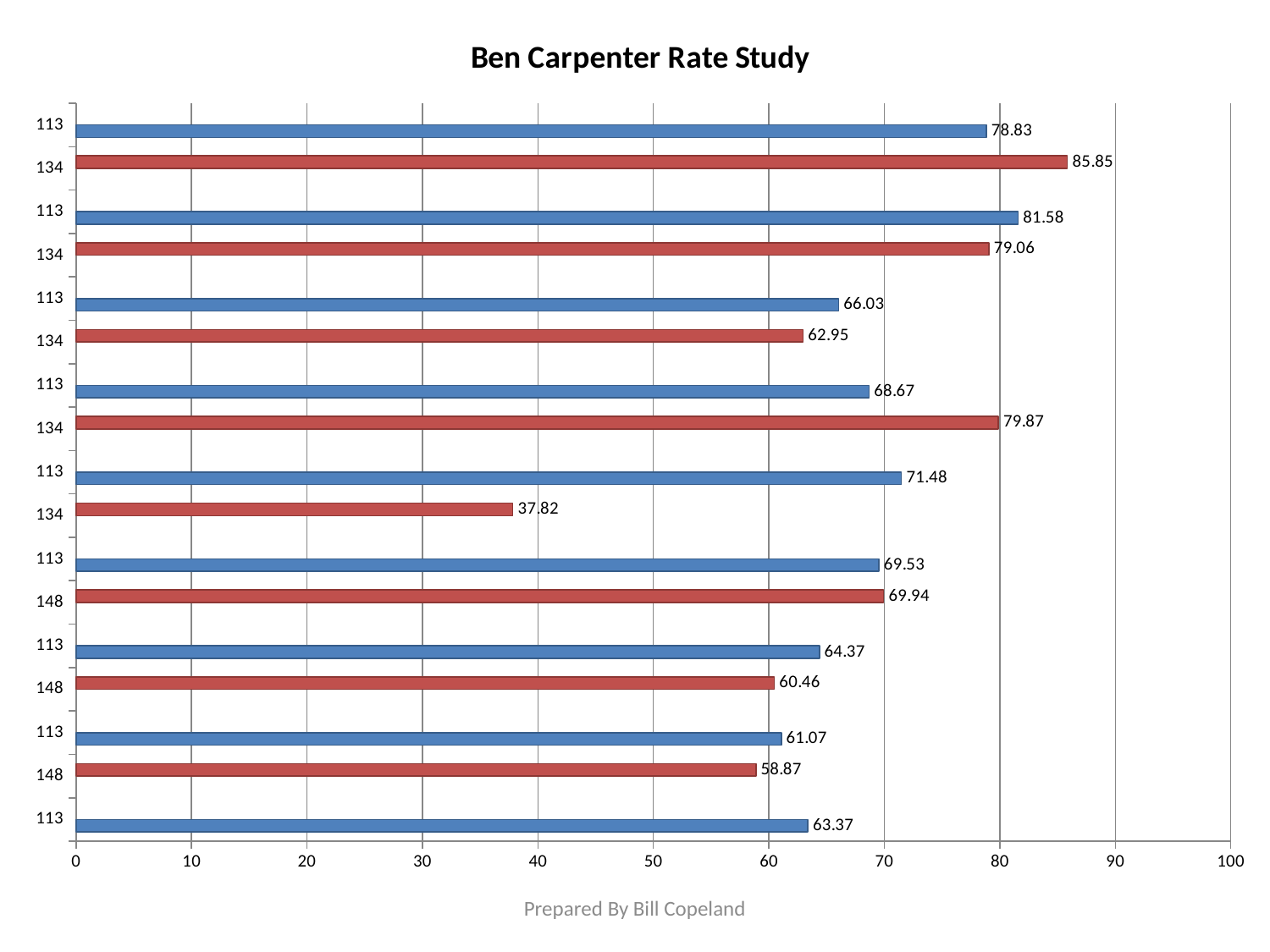
What is the value of the bottom bar in the chart? 63.37 How many bars are plotted in the chart? 17 What is the difference between the highest value (85.85) and the lowest value (37.82) in the chart? 48.03 What is the lowest value shown in the chart? 37.82 What is the value of the third bar from the top? 81.58 What is the value of the topmost bar in the chart? 78.83 How many bars are labeled 148 on the vertical axis? 3 What kind of chart is shown on the slide? bar chart What is the title of the chart? Ben Carpenter Rate Study What is the highest value shown in the chart? 85.85 Which is larger, the topmost bar or the bottom bar? the topmost bar Is the value of the shortest bar greater or less than 40? less